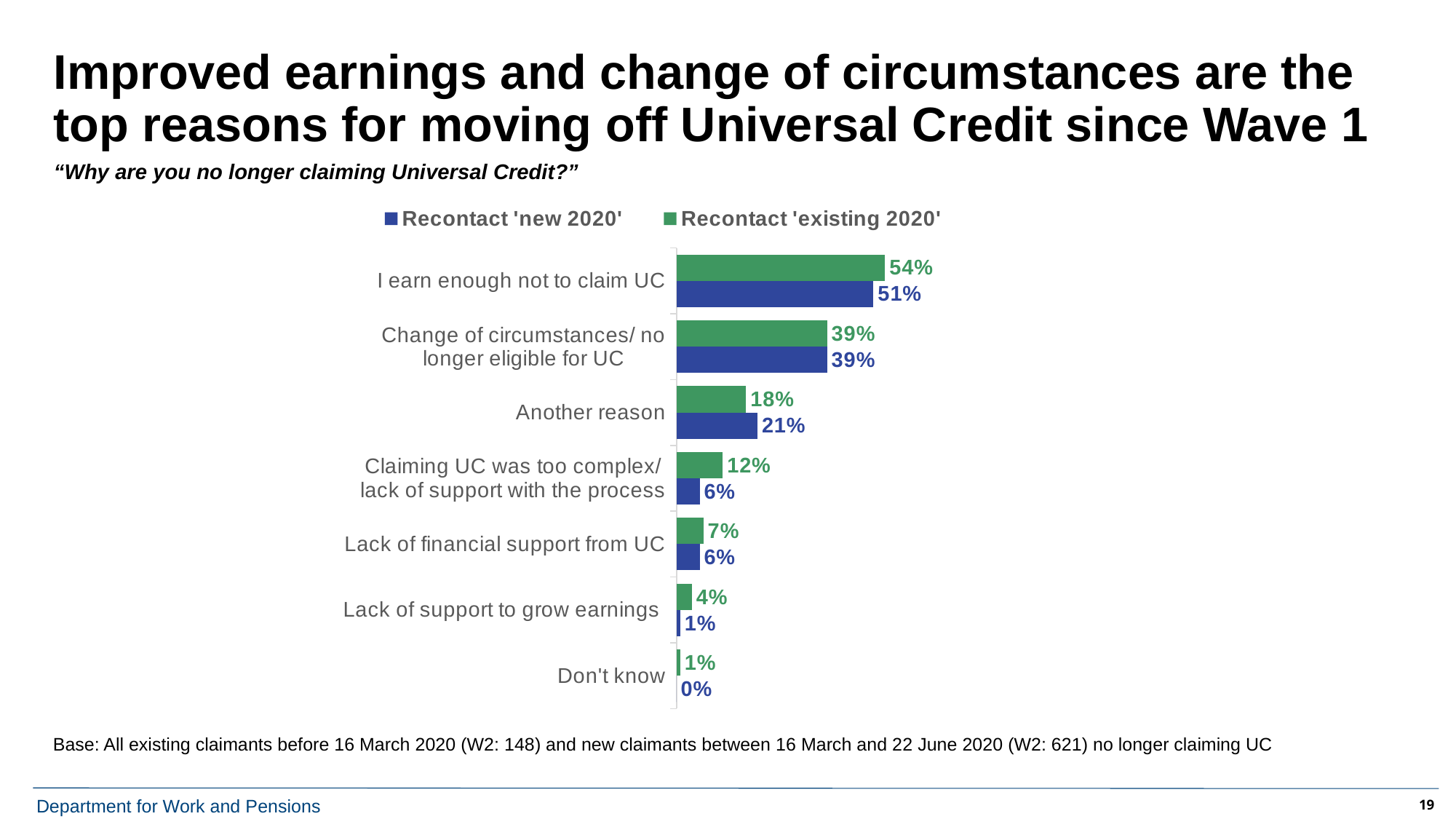
What is the Recontact 'new 2020' value for 'Claiming UC was too complex/ lack of support with the process'? 6% Which reason has the lowest value for Recontact 'existing 2020'? Don't know What colour represents the Recontact 'existing 2020' series? Green How many series does the legend list? 2 Which reason has the highest value for Recontact 'new 2020'? I earn enough not to claim UC What percentage of Recontact 'new 2020' respondents gave 'Another reason'? 21% For 'Claiming UC was too complex/ lack of support with the process', which series has the larger value? Recontact 'existing 2020' For 'Another reason', which series has the larger value? Recontact 'new 2020' How many reason categories are shown in the chart? 7 What is the difference between the Recontact 'existing 2020' and Recontact 'new 2020' values for 'I earn enough not to claim UC'? 3 percentage points What type of chart is shown on the slide? Bar chart What percentage of Recontact 'existing 2020' respondents said 'I earn enough not to claim UC'? 54%